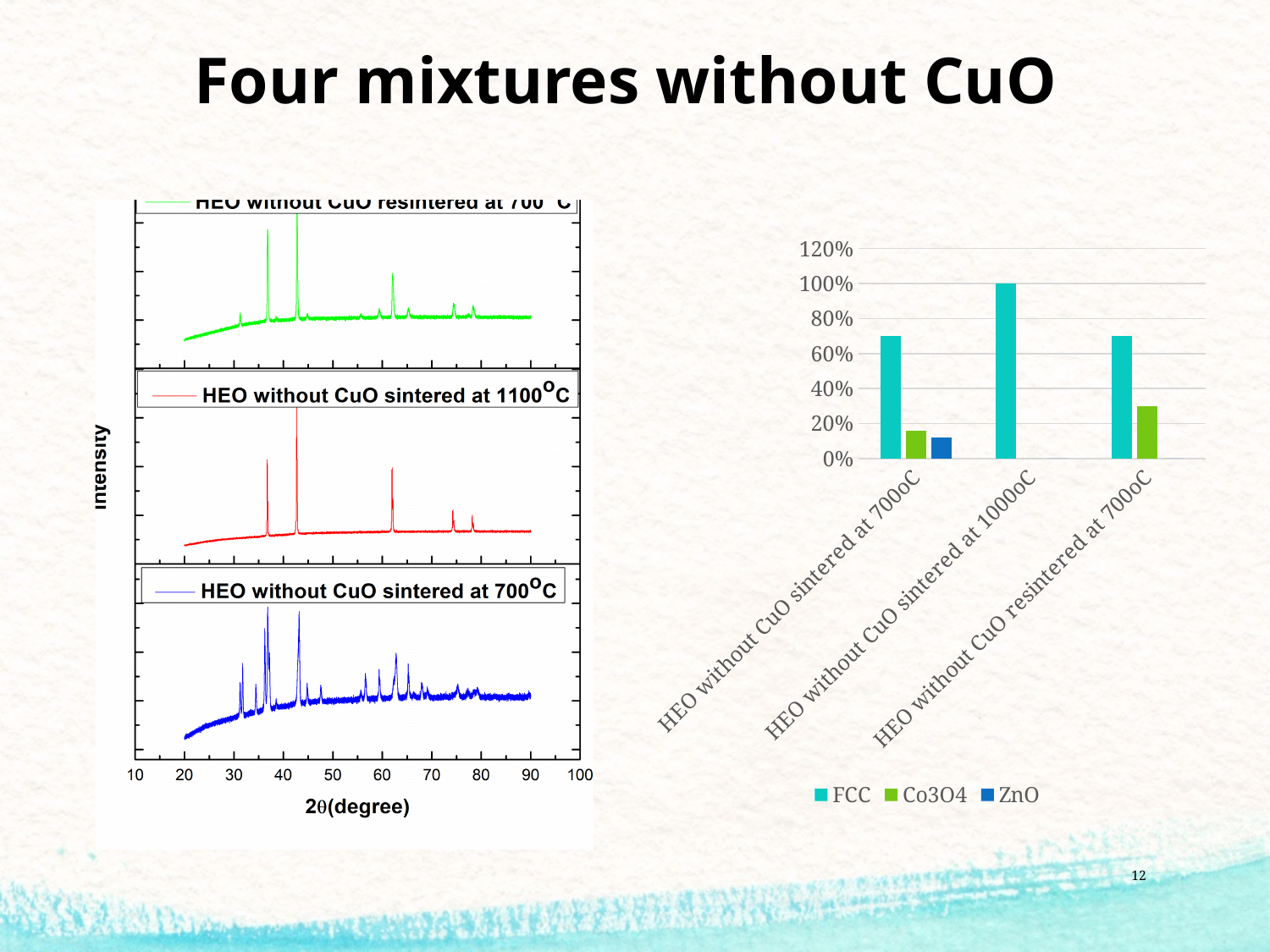
In the bar chart on the right, which category has the highest FCC value? HEO without CuO sintered at 1000oC In the bar chart on the right, is the Co3O4 value for HEO without CuO sintered at 700oC greater or less than 20%? less In the bar chart on the right, how many categories are shown on the x axis? 3 In the bar chart on the right, what is the FCC value for HEO without CuO sintered at 1000oC? 100% In the bar chart on the right, is the Co3O4 value for HEO without CuO resintered at 700oC greater or less than 20%? greater In the bar chart on the right, is the FCC value for HEO without CuO sintered at 700oC greater or less than 60%? greater What kind of chart is the chart on the right of the slide? Bar chart In the bar chart on the right, how many series does the legend list? 3 In the bar chart on the right, which category has a ZnO bar? HEO without CuO sintered at 700oC What is the x-axis label of the chart on the left of the slide? 2θ(degree) In the bar chart on the right, what are the series named in the legend? FCC, Co3O4, ZnO In the bar chart on the right, which is larger for HEO without CuO sintered at 700oC: the Co3O4 value or the ZnO value? Co3O4